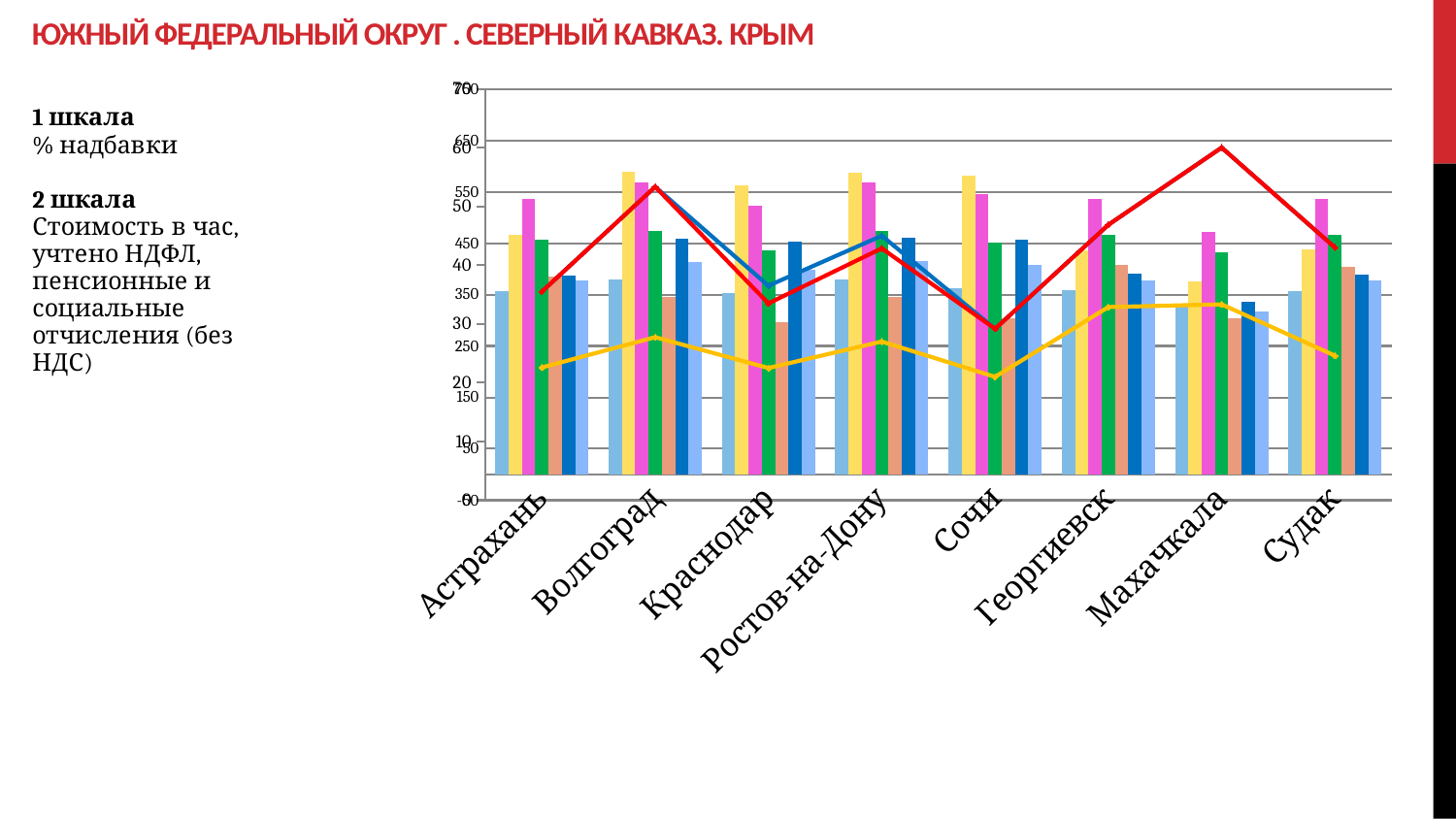
Which category is listed last on the x axis of the chart? Судак Which category is listed first on the x axis of the chart? Астрахань How many categories are shown along the x axis of the chart? 8 Is the red line higher at Махачкала or at Судак? Махачкала Does the yellow line rise or fall from Махачкала to Судак? Falls At which category does the red line reach its highest point? Махачкала How many bars are plotted for each category in the chart? 7 At which category does the red line reach its lowest point? Сочи Is the red line higher at Волгоград or at Краснодар? Волгоград What kind of chart is shown on the slide? A combined bar and line chart Does the red line rise or fall from Махачкала to Судак? Falls Does the red line rise or fall from Георгиевск to Махачкала? Rises